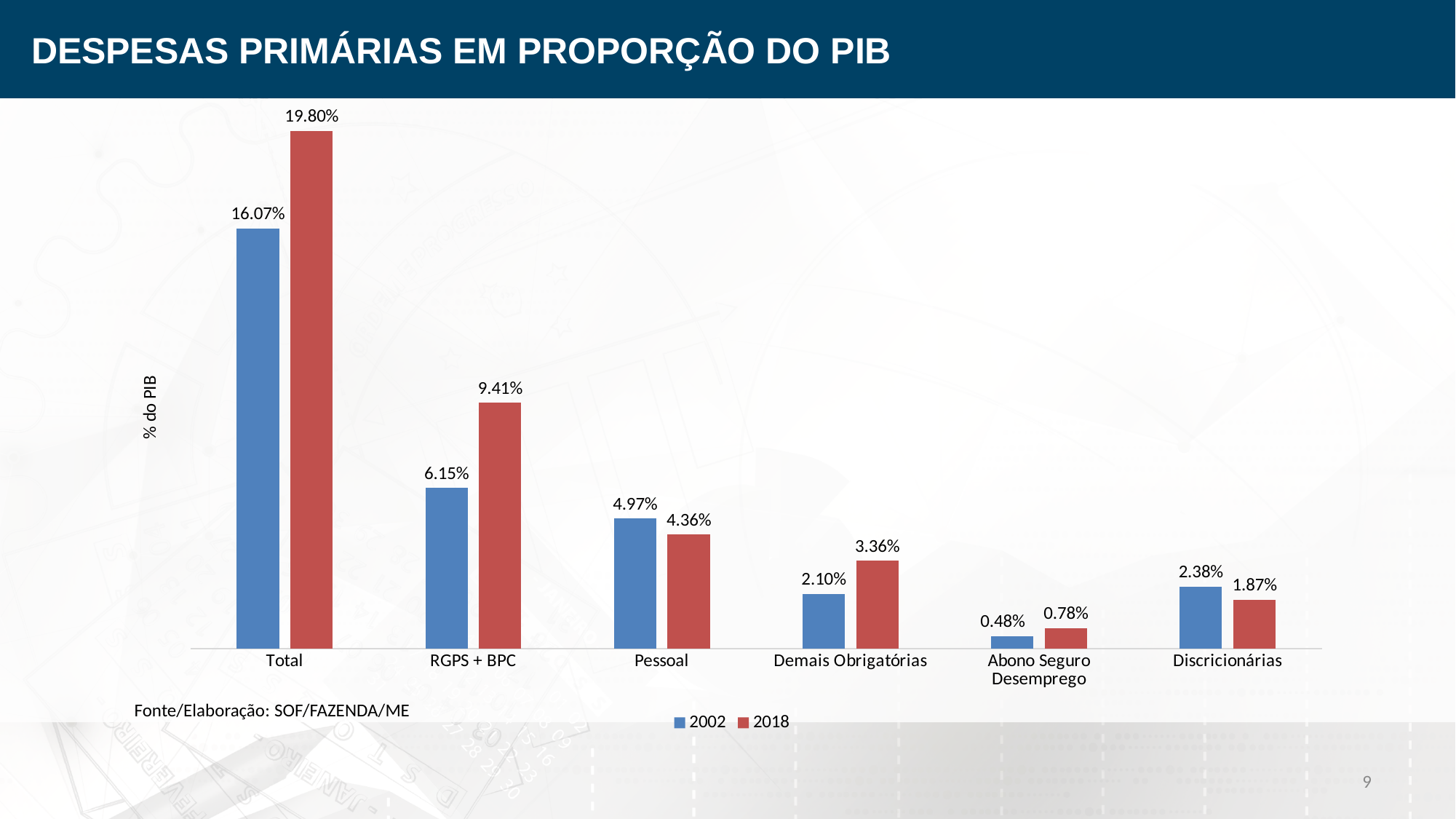
What is the value for RGPS + BPC in 2002? 6.15% How many categories are shown on the x axis? 6 What is the value for Discricionárias in 2002? 2.38% What is the difference between the 2018 and 2002 values for Total? 3.73% What kind of chart is shown on the slide? Bar chart How many series does the legend list? 2 Which category has the lowest value in 2002? Abono Seguro Desemprego Which category has the highest value in 2018? Total What is the title of the chart? DESPESAS PRIMÁRIAS EM PROPORÇÃO DO PIB What is the value for Total in 2018? 19.80% Which is larger for Pessoal, the 2002 value or the 2018 value? 2002 What is the value for Abono Seguro Desemprego in 2018? 0.78%